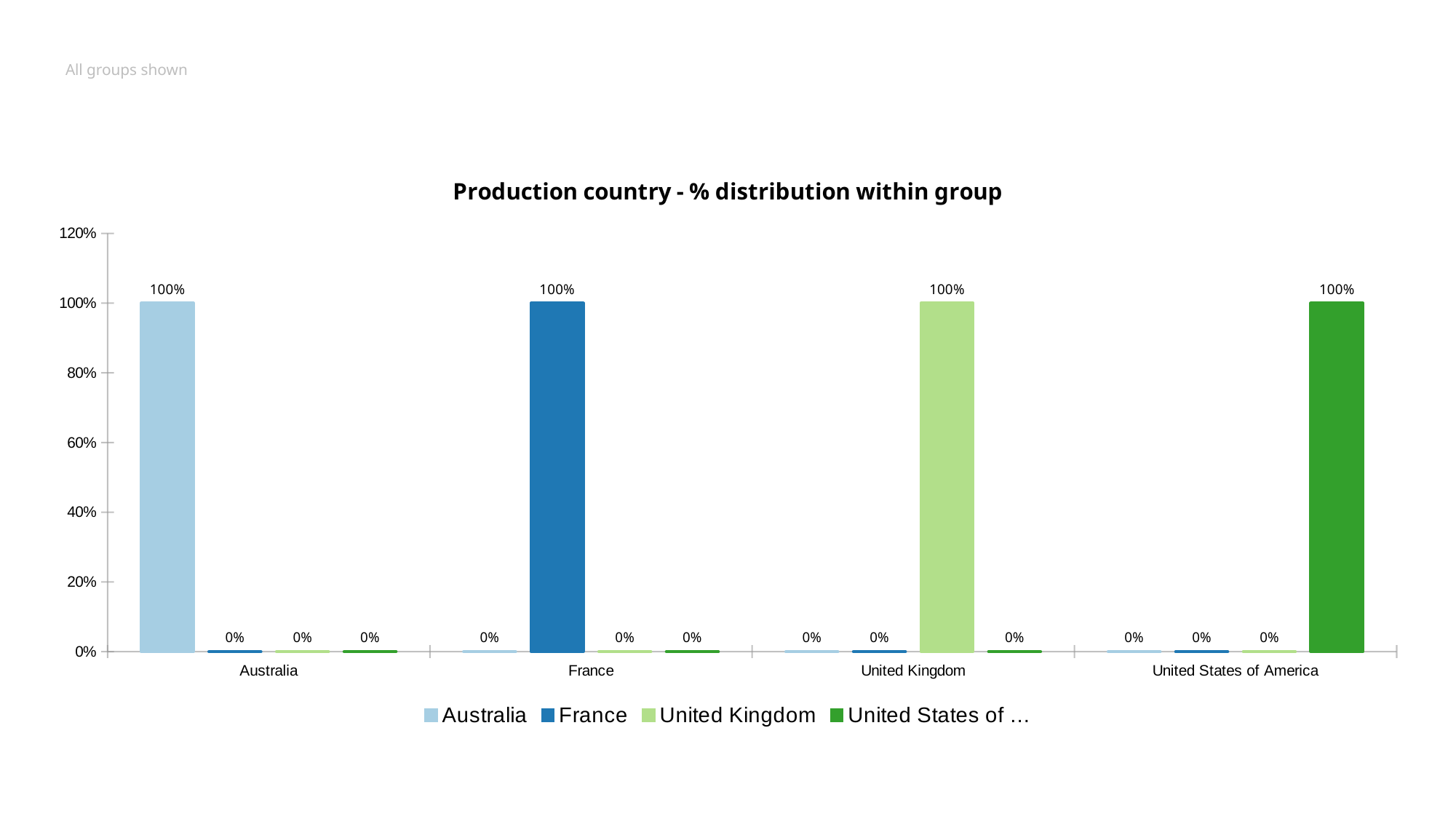
What is the difference between the France series and the Australia series in the France group? 100% What is the value of the Australia series in the Australia group? 100% What is the value of the United Kingdom series in the United Kingdom group? 100% In the United Kingdom group, which is larger: the United Kingdom series or the France series? United Kingdom How many series does the legend list? 4 What is the value of the Australia series in the United States of America group? 0% What kind of chart is shown on the slide? bar chart What is the value of the France series in the Australia group? 0% Which series has the highest value in the United States of America group? United States of America What is the title of the chart? Production country - % distribution within group How many categories are shown on the x axis? 4 What is the value of the France series in the France group? 100%